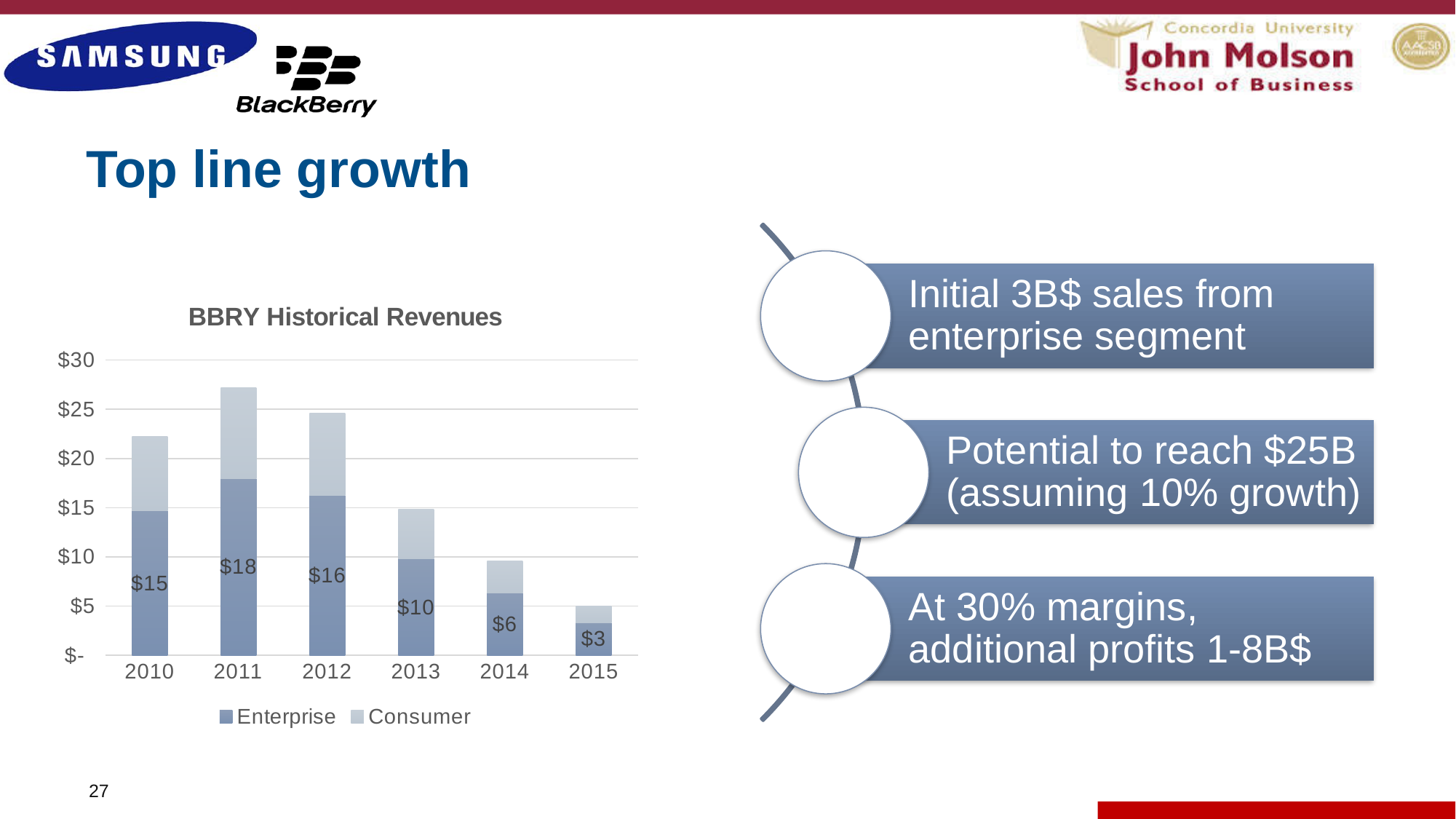
Which is larger, the Enterprise value for 2012 or for 2013? 2012 What is the Enterprise value for 2011 in the BBRY Historical Revenues chart? $18 How many years are shown on the x axis of the BBRY Historical Revenues chart? 6 What kind of chart is the BBRY Historical Revenues chart? Stacked bar chart What is the Enterprise value for 2014 in the BBRY Historical Revenues chart? $6 From 2011 to 2015, do the Enterprise values rise or fall? Fall Is the total stacked bar for 2011 greater or less than $25? greater Which year has the highest Enterprise value in the BBRY Historical Revenues chart? 2011 Which year has the lowest Enterprise value in the BBRY Historical Revenues chart? 2015 How many series does the legend of the BBRY Historical Revenues chart list? 2 Is the total stacked bar for 2015 greater or less than $10? less What is the difference between the Enterprise values for 2011 and 2010? $3